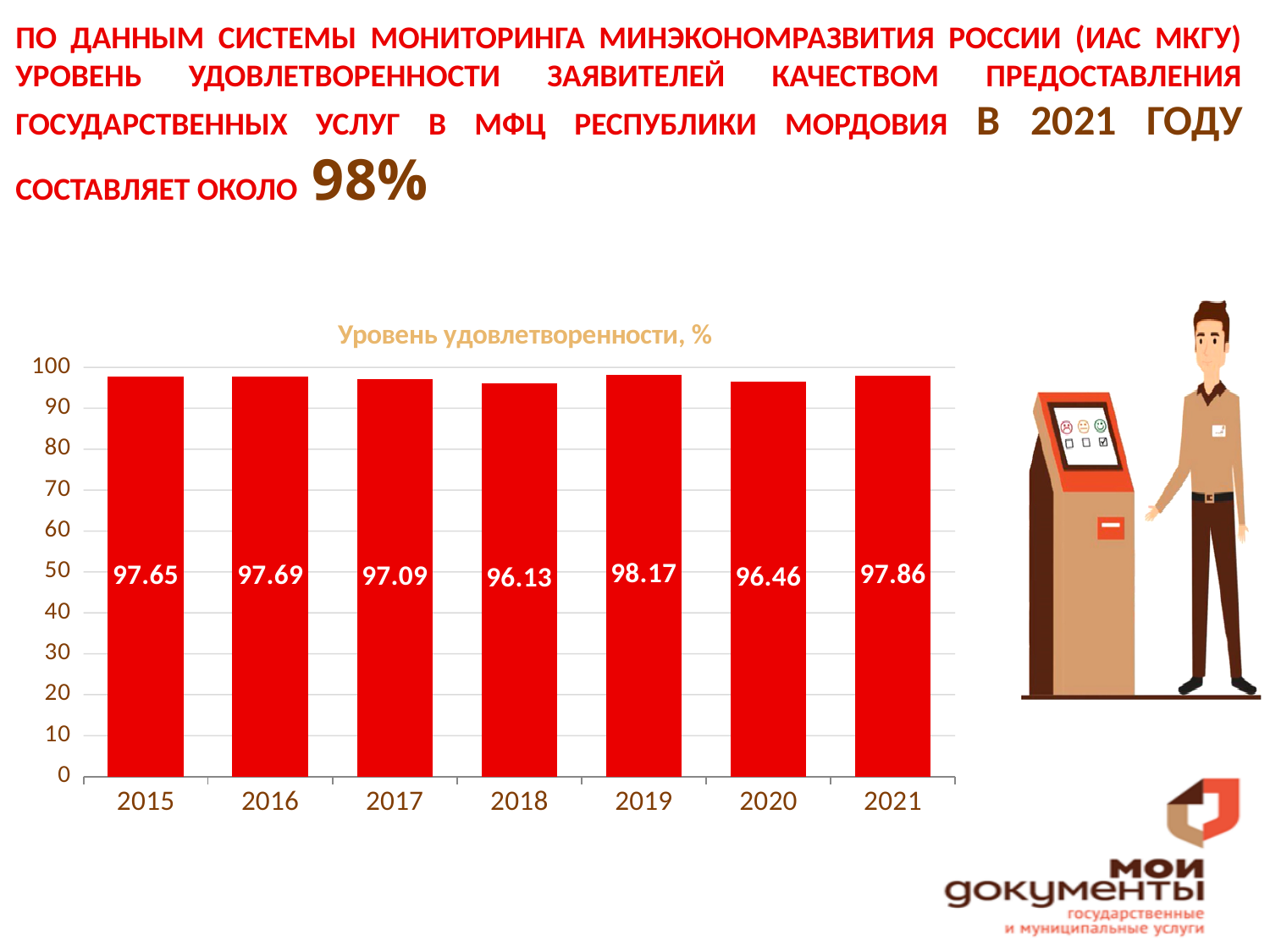
What is the difference between the satisfaction levels for 2021 and 2020? 1.4 What is the satisfaction level shown for 2021? 97.86 How many years are shown on the x axis of the chart? 7 Which is larger, the value for 2017 or the value for 2020? 2017 What kind of chart is shown on the slide? bar chart Which year has the lowest satisfaction level? 2018 What is the satisfaction level shown for 2018? 96.13 What is the satisfaction level shown for 2019? 98.17 What is the satisfaction level shown for 2015? 97.65 Which year has the highest satisfaction level? 2019 What is the title of the chart? Уровень удовлетворенности, % What is the difference between the satisfaction levels for 2019 and 2018? 2.04